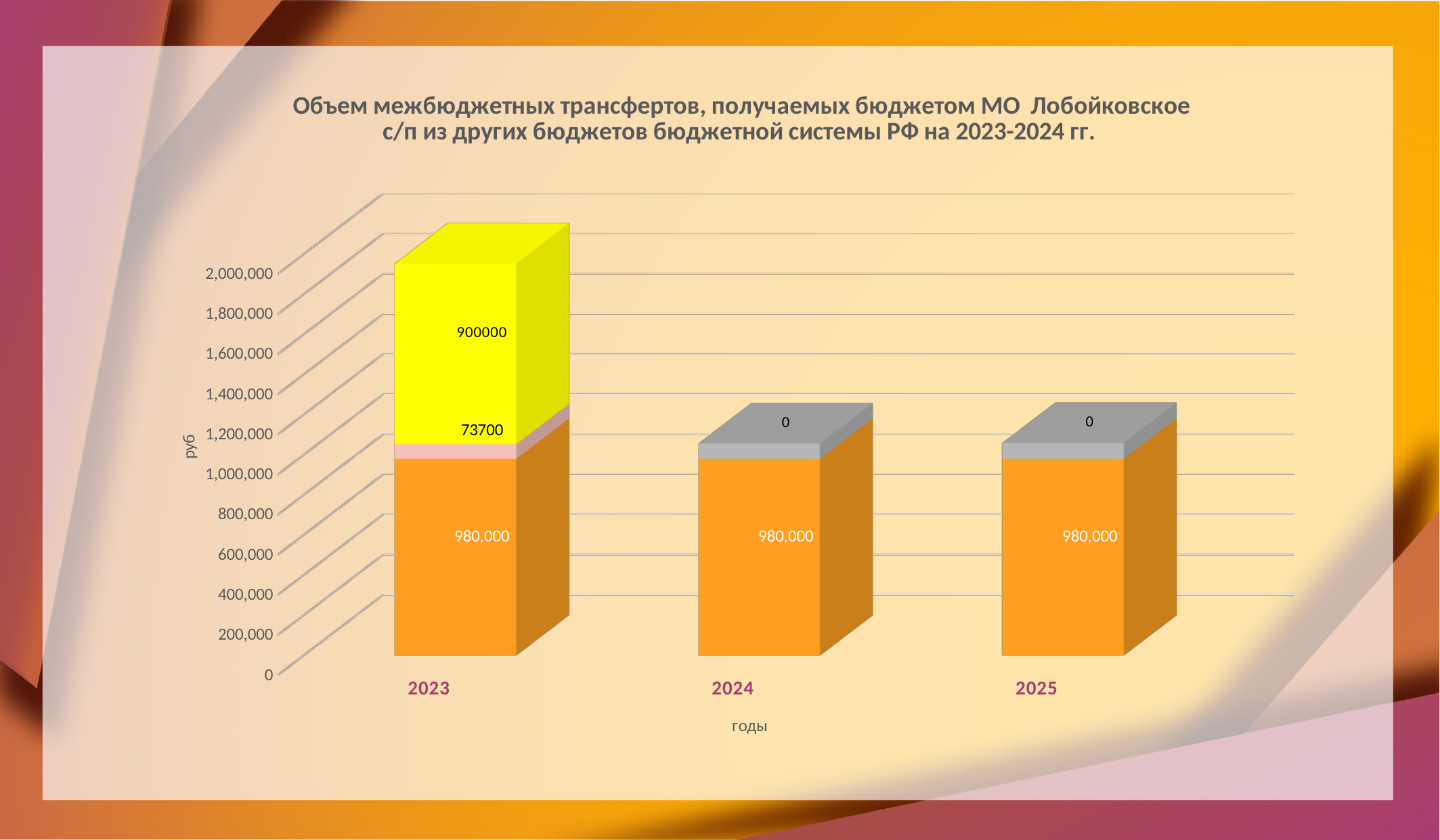
What is the value of the orange segment for 2025? 980,000 Which year has the highest total bar? 2023 Is the total bar for 2023 greater or less than 1,800,000? greater What is the difference between the orange segment (980,000) and the yellow segment (900000) for 2023? 80,000 What is the value of the yellow segment for 2023? 900000 How many years (categories) are shown on the x axis of the chart? 3 What is the total of the stacked bar for 2023? 1,953,700 What is the title of the x axis of the chart? годы What is the value of the orange segment for 2023? 980,000 What is the value of the pink segment for 2023? 73700 What kind of chart is shown on the slide? bar chart